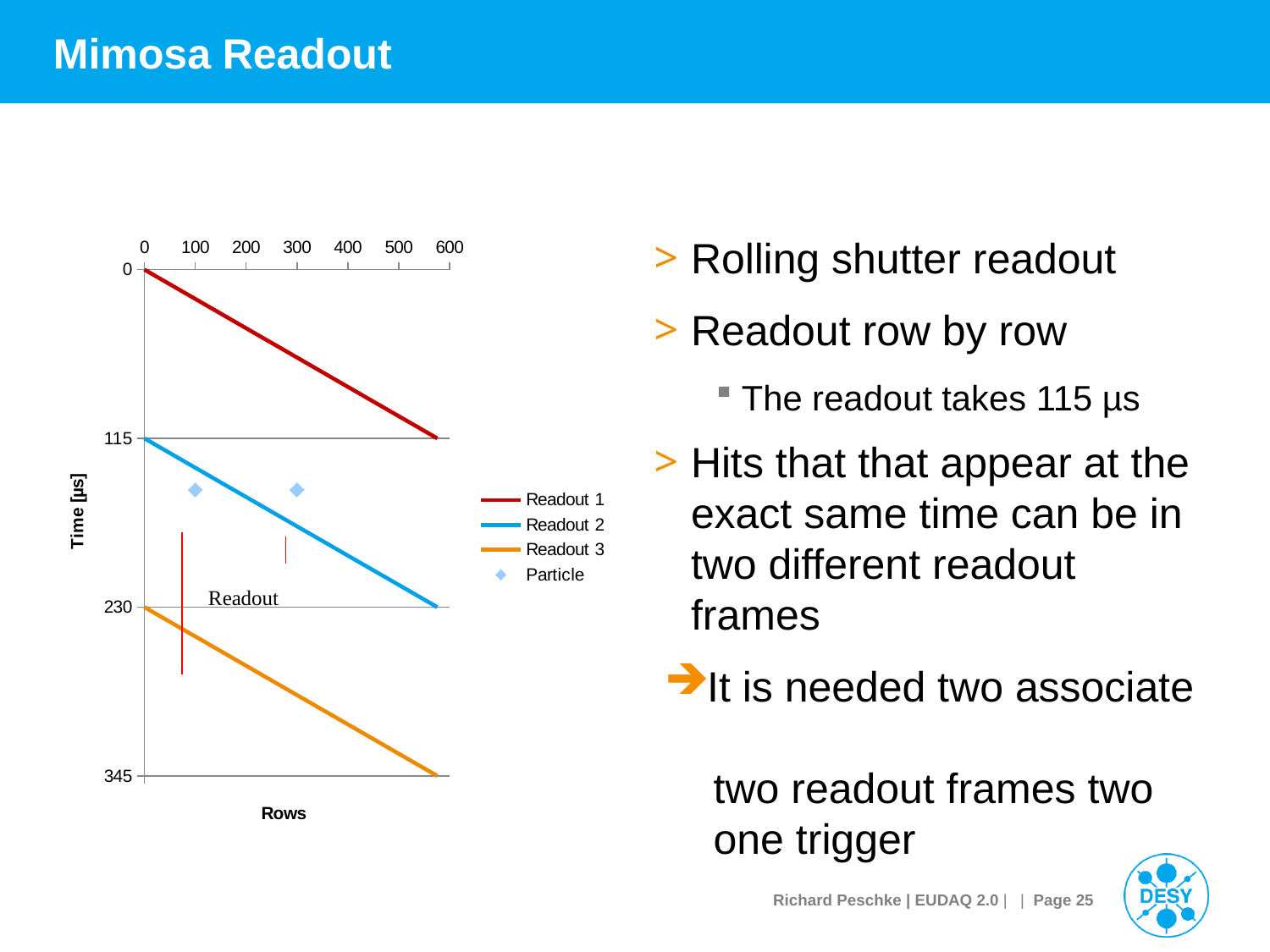
At row 0, what time value does Readout 1 start at? 0 Is the time value of Readout 1 at row 300 greater or less than 115? less How many Particle markers are plotted on the chart? 2 What kind of chart is shown on the slide? line chart Does the time value of each readout line rise or fall as the row number increases? rise At row 0, what time value does Readout 3 start at? 230 How many entries does the chart legend list? 4 At row 0, which has the larger time value, Readout 1 or Readout 3? Readout 3 At row 0, what time value does Readout 2 start at? 115 What is the title of the x axis? Rows Is the time value of Readout 2 at row 300 greater or less than 230? less What time value does Readout 3 reach at the end of its line? 345